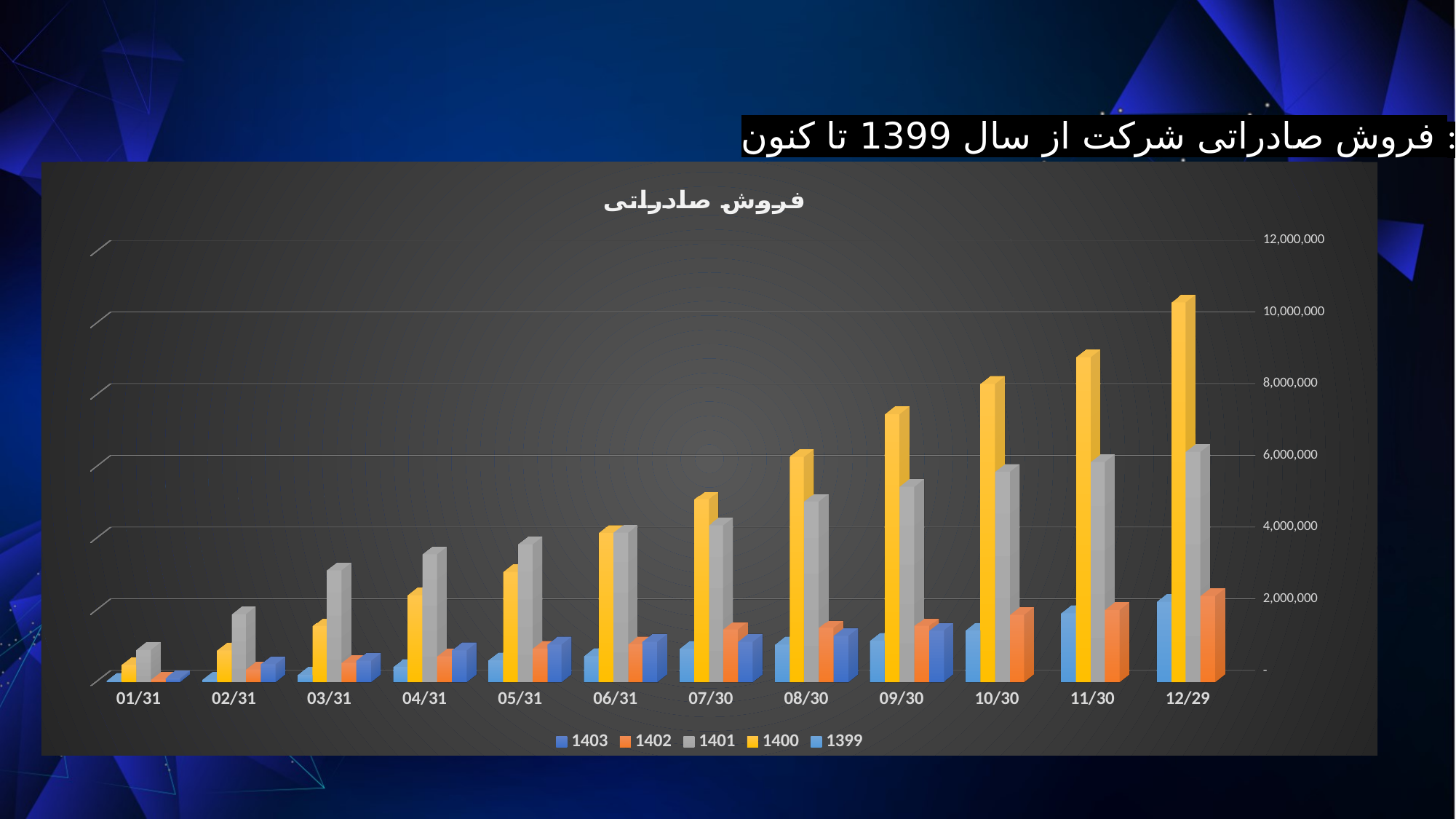
Is the value for the 1400 series at 09/30 greater or less than 8,000,000? less How many series does the chart's legend list? 5 At 03/31, which series has the larger value, 1400 or 1401? 1401 Which category has the lowest value for the 1400 series? 01/31 Which category has the highest value for the 1400 series? 12/29 Do the values of the 1400 series rise or fall from 01/31 to 12/29? rise Which series is shown in yellow in the chart's legend? 1400 At 12/29, which series has the larger value, 1400 or 1401? 1400 Is the value for the 1400 series at 12/29 greater or less than 10,000,000? greater Is the value for the 1400 series at 01/31 greater or less than 2,000,000? less How many categories are shown on the x axis of the chart? 12 What kind of chart is shown on the slide? bar chart